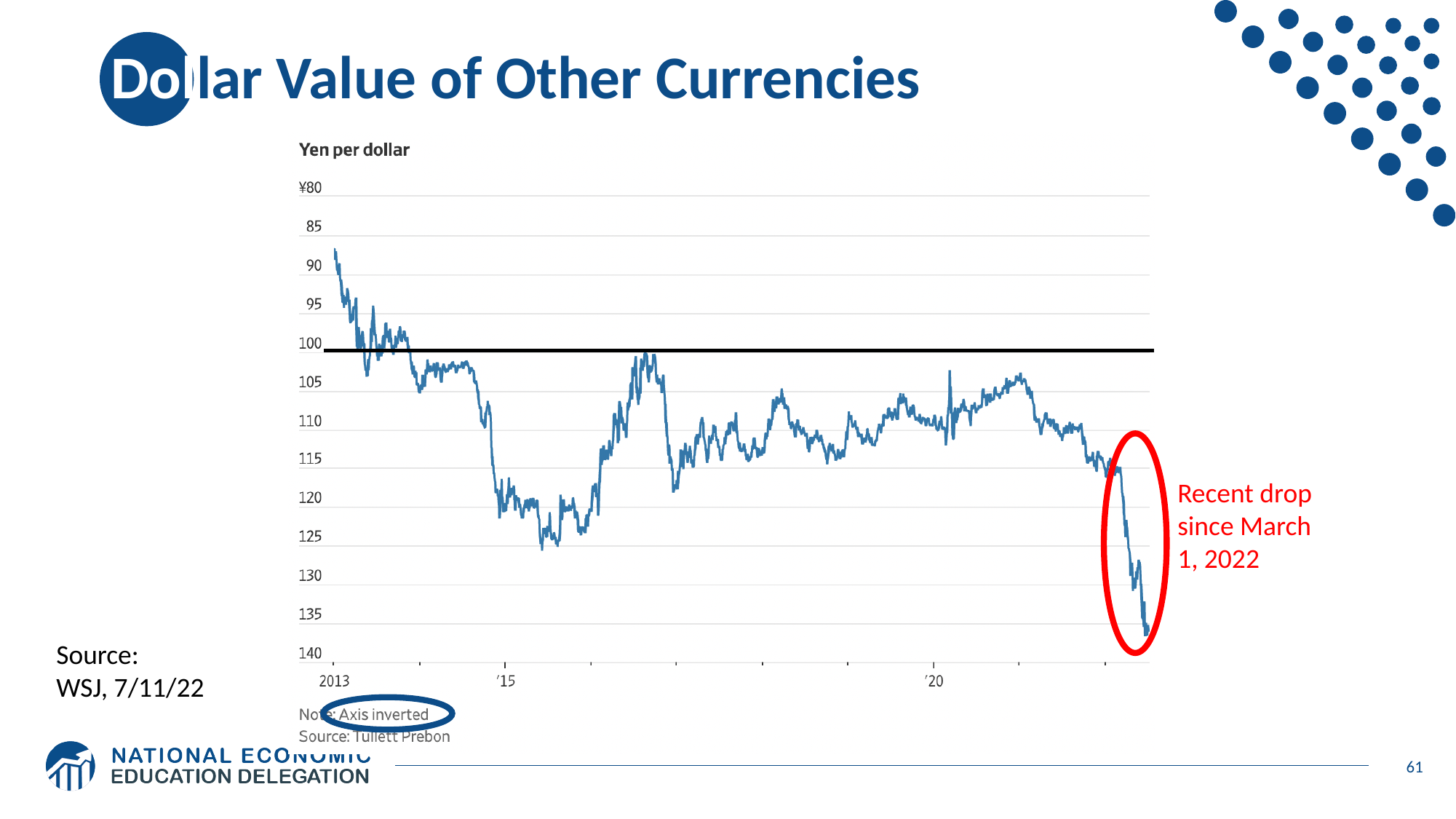
Is the yen per dollar value at the start of 2015 greater or less than 110? greater What is the title of the chart? Yen per dollar What does the note below the chart say about the axis? Axis inverted What kind of chart is shown on the slide? line chart Does the yen per dollar value rise or fall from March 2022 to the end of the series? rise Is the yen per dollar value at the start of 2020 greater or less than 100? greater Is the yen per dollar value at the start of the series in 2013 greater or less than 100? less Does the yen per dollar value rise or fall from 2013 to the start of 2015? rise